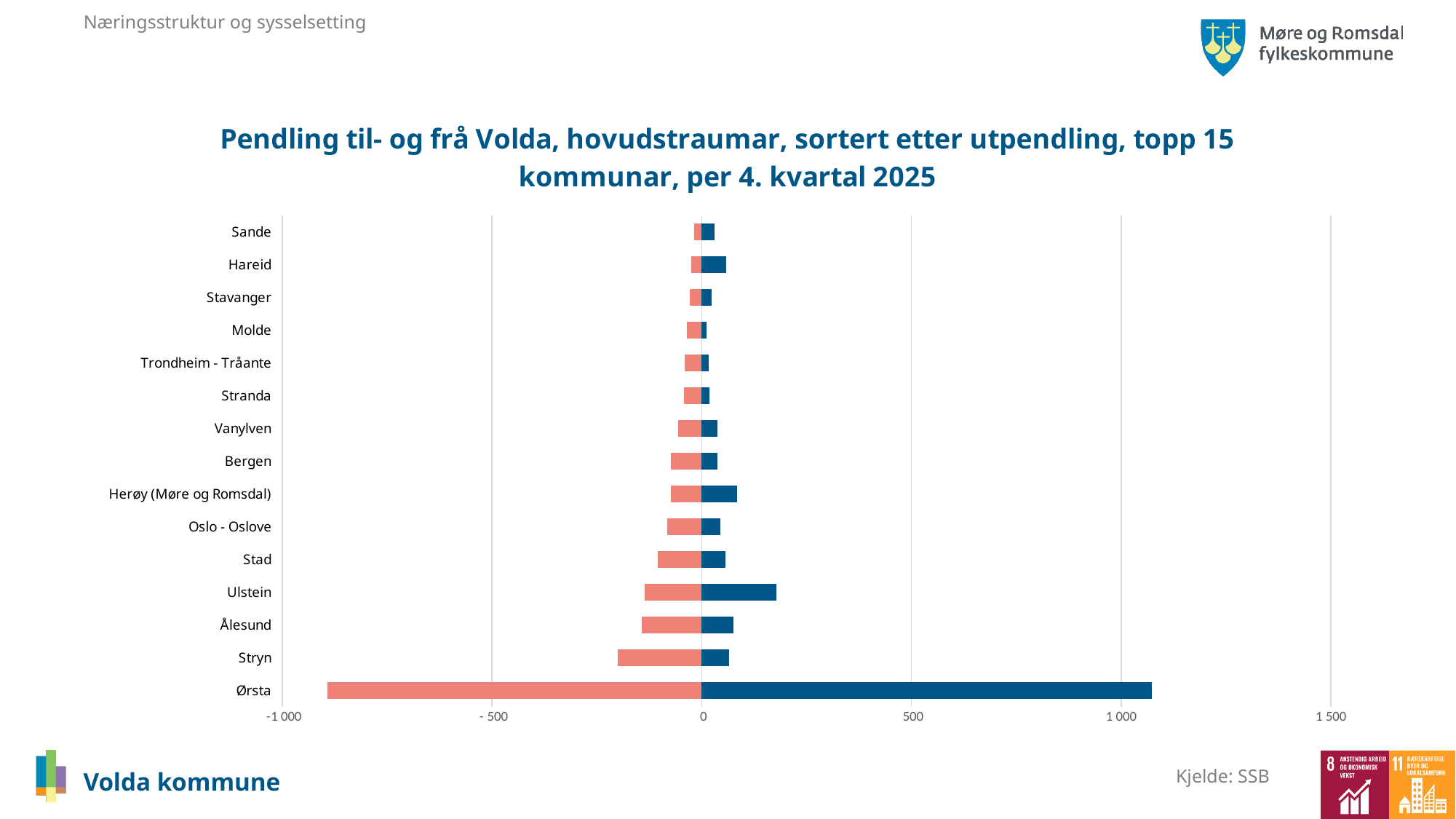
Which municipality is listed at the top of the vertical axis? Sande What kind of chart is shown on the slide? bar chart Which has the longer blue bar, Ulstein or Ålesund? Ulstein Which municipality has the longest blue bar (innpendling) in the chart? Ørsta Which has the longer red bar, Stryn or Stad? Stryn What is the highest value shown on the horizontal axis of the chart? 1 500 Does the red bar for Ørsta extend beyond -500 on the axis? yes Is the blue bar for Ørsta greater or less than 1 000? greater Which municipality has the longest red bar (utpendling) in the chart? Ørsta What is the title of the chart? Pendling til- og frå Volda, hovudstraumar, sortert etter utpendling, topp 15 kommunar, per 4. kvartal 2025 How many municipalities (categories) are listed on the vertical axis of the chart? 15 Is the blue bar for Ulstein greater or less than 500? less